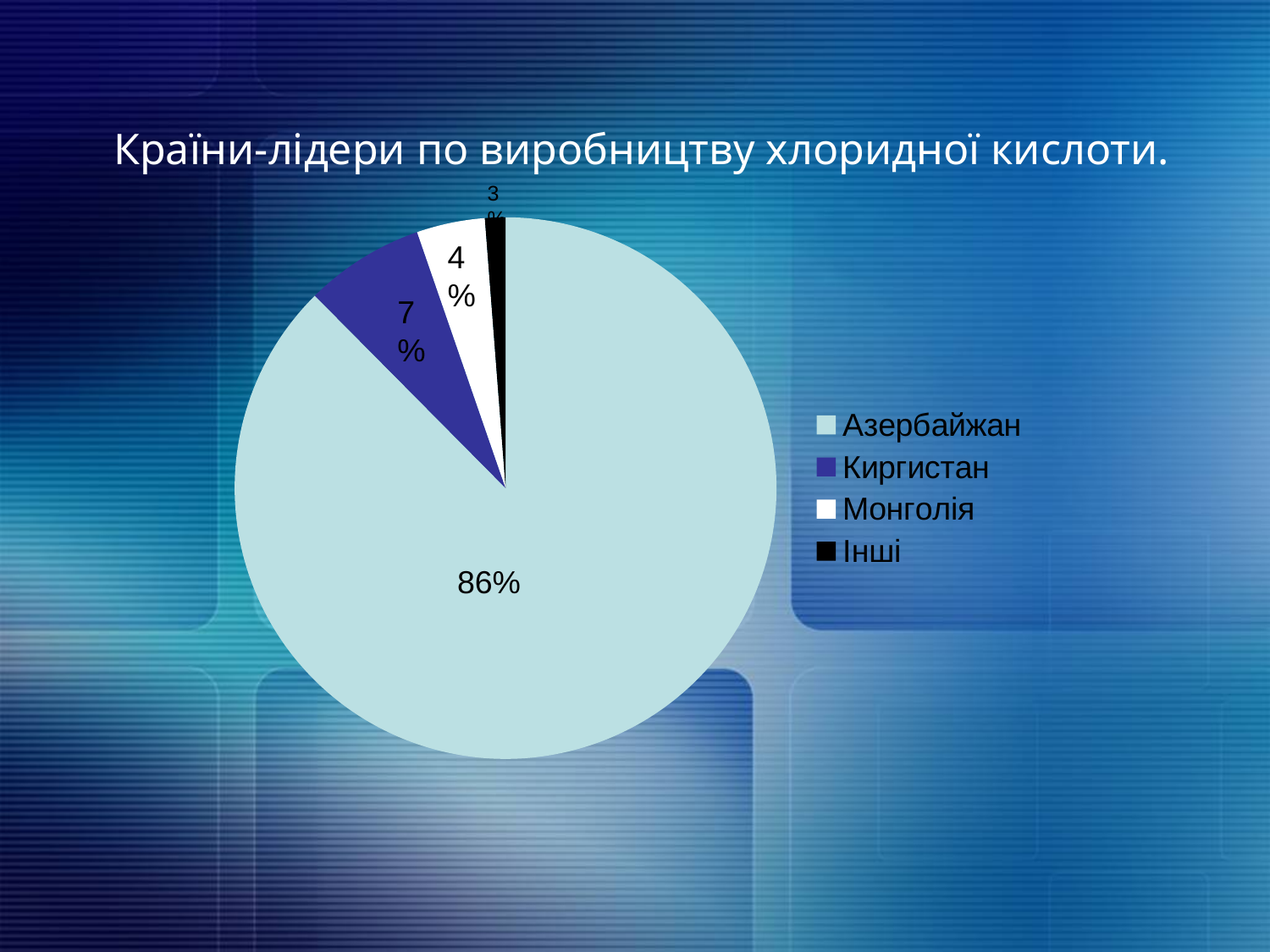
How many categories does the pie chart show? 4 Which has a larger share, Киргистан or Монголія? Киргистан What share of the pie does Монголія hold? 4% What share of the pie does Азербайжан hold? 86% By how many percentage points does the share of Киргистан exceed that of Монголія? 3 Which category has the smallest slice of the pie? Інші By how many percentage points does the share of Азербайжан exceed that of Киргистан? 79 What kind of chart is shown on the slide? pie chart What share of the pie does Киргистан hold? 7% Which category has the largest slice of the pie? Азербайжан What is the title of the chart? Країни-лідери по виробництву хлоридної кислоти. What colour is the slice for Інші? black